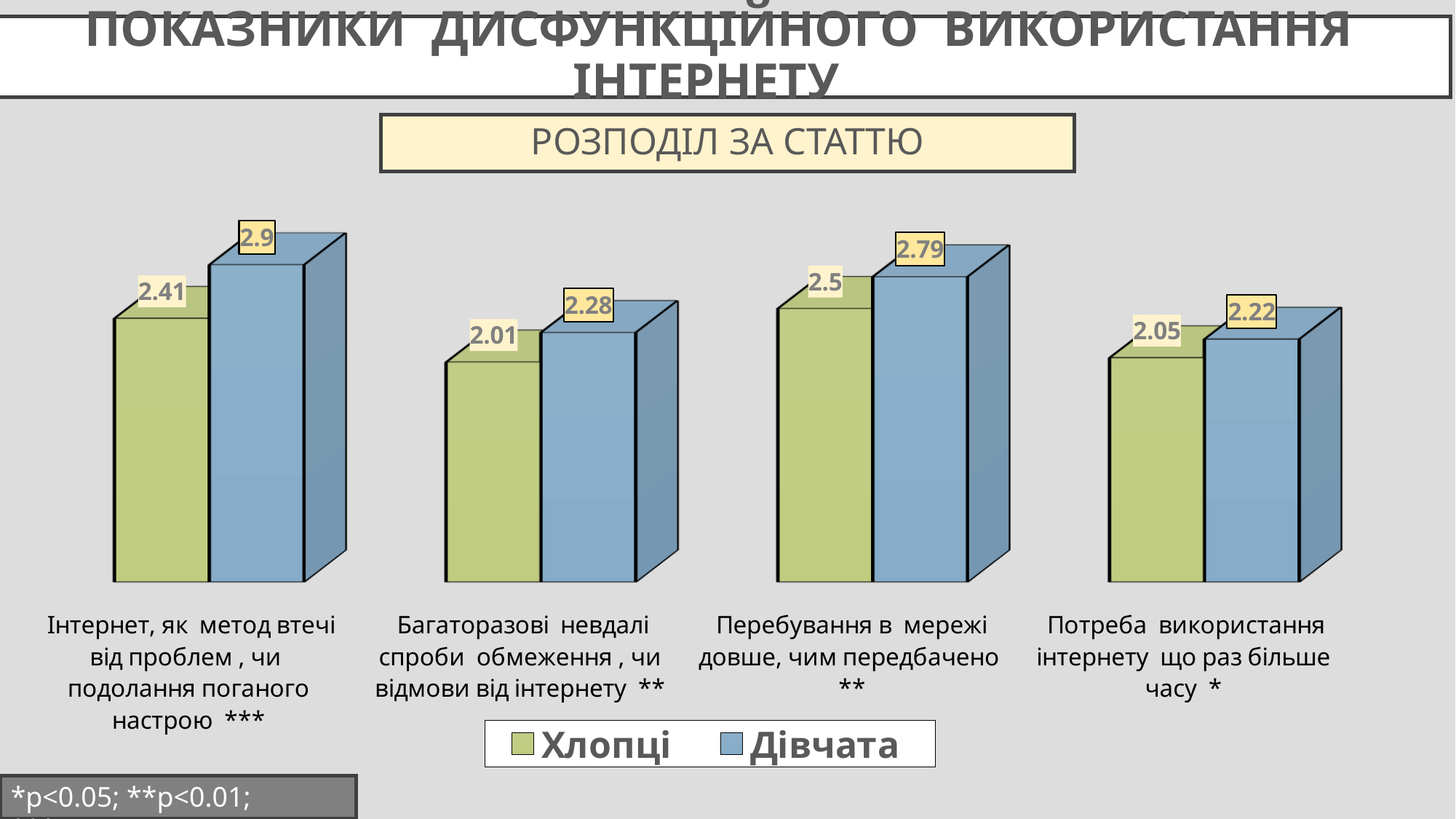
What is the difference between the Дівчата and Хлопці values in the category "Перебування в мережі довше, чим передбачено"? 0.29 What kind of chart is shown on the slide? Bar chart In the category "Потреба використання інтернету що раз більше часу", which series has the larger value, Хлопці or Дівчата? Дівчата How many categories are shown on the chart? 4 What is the value for Хлопці in the category "Багаторазові невдалі спроби обмеження, чи відмови від інтернету"? 2.01 Which colour represents the Хлопці series in the legend? Green How many series does the legend list? 2 What is the value for Дівчата in the category "Потреба використання інтернету що раз більше часу"? 2.22 Which category has the highest value for Дівчата? Інтернет, як метод втечі від проблем, чи подолання поганого настрою Which category has the lowest value for Хлопці? Багаторазові невдалі спроби обмеження, чи відмови від інтернету What is the value for Хлопці in the category "Перебування в мережі довше, чим передбачено"? 2.5 What is the value for Дівчата in the category "Інтернет, як метод втечі від проблем, чи подолання поганого настрою"? 2.9